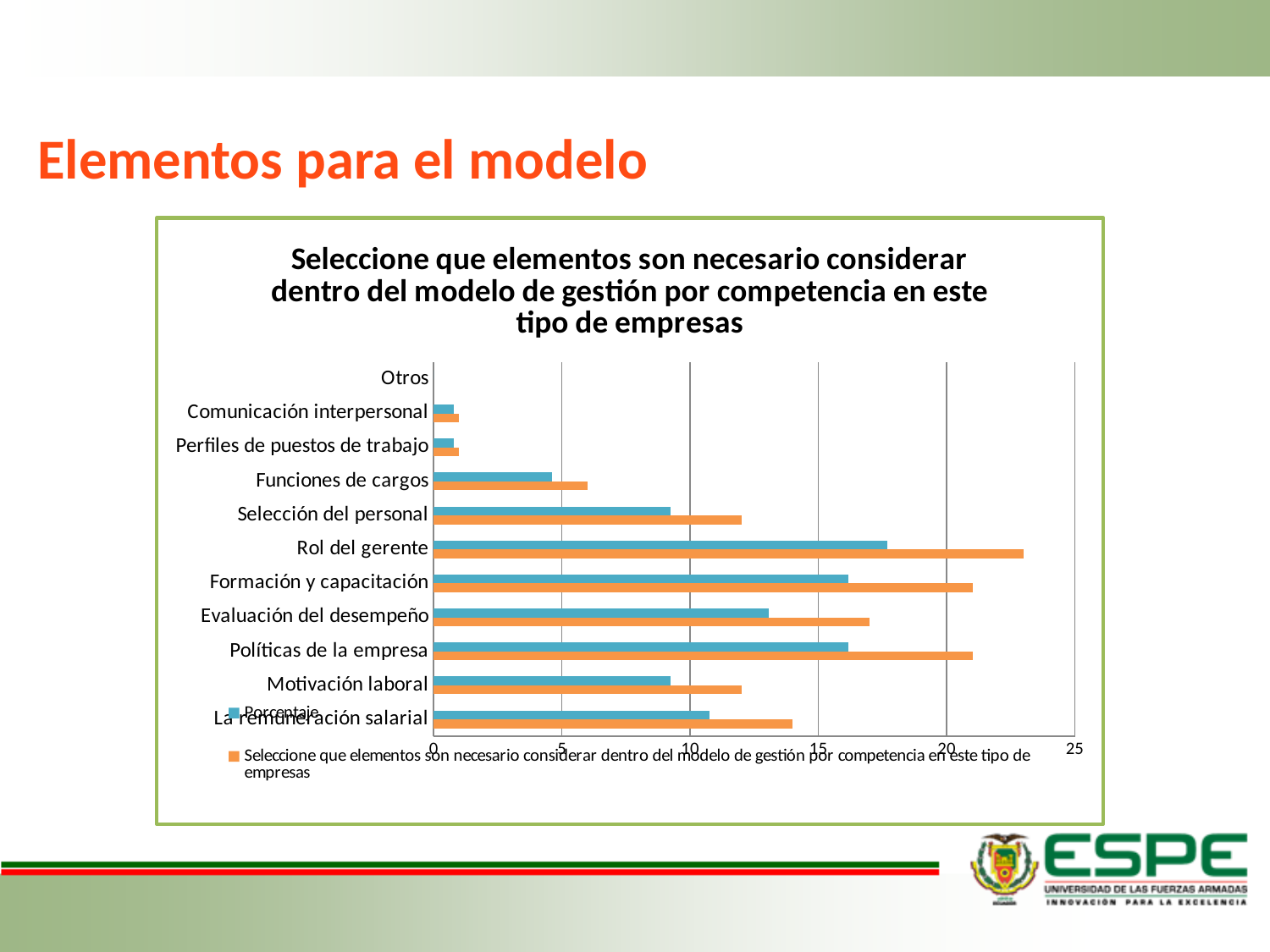
Is the orange-series value for Evaluación del desempeño greater or less than 15? greater What kind of chart is shown on the slide? bar chart What is the name of the first series listed in the chart's legend? Porcentaje Is the Porcentaje (blue) value for Rol del gerente greater or less than 15? greater Which category has the highest value in the orange series? Rol del gerente How many series does the chart's legend list? 2 Which category has the lowest value in the chart? Otros Is the orange-series value for Rol del gerente greater or less than 20? greater How many categories are listed on the vertical axis of the chart? 11 In the orange series, which is larger: Rol del gerente or Selección del personal? Rol del gerente